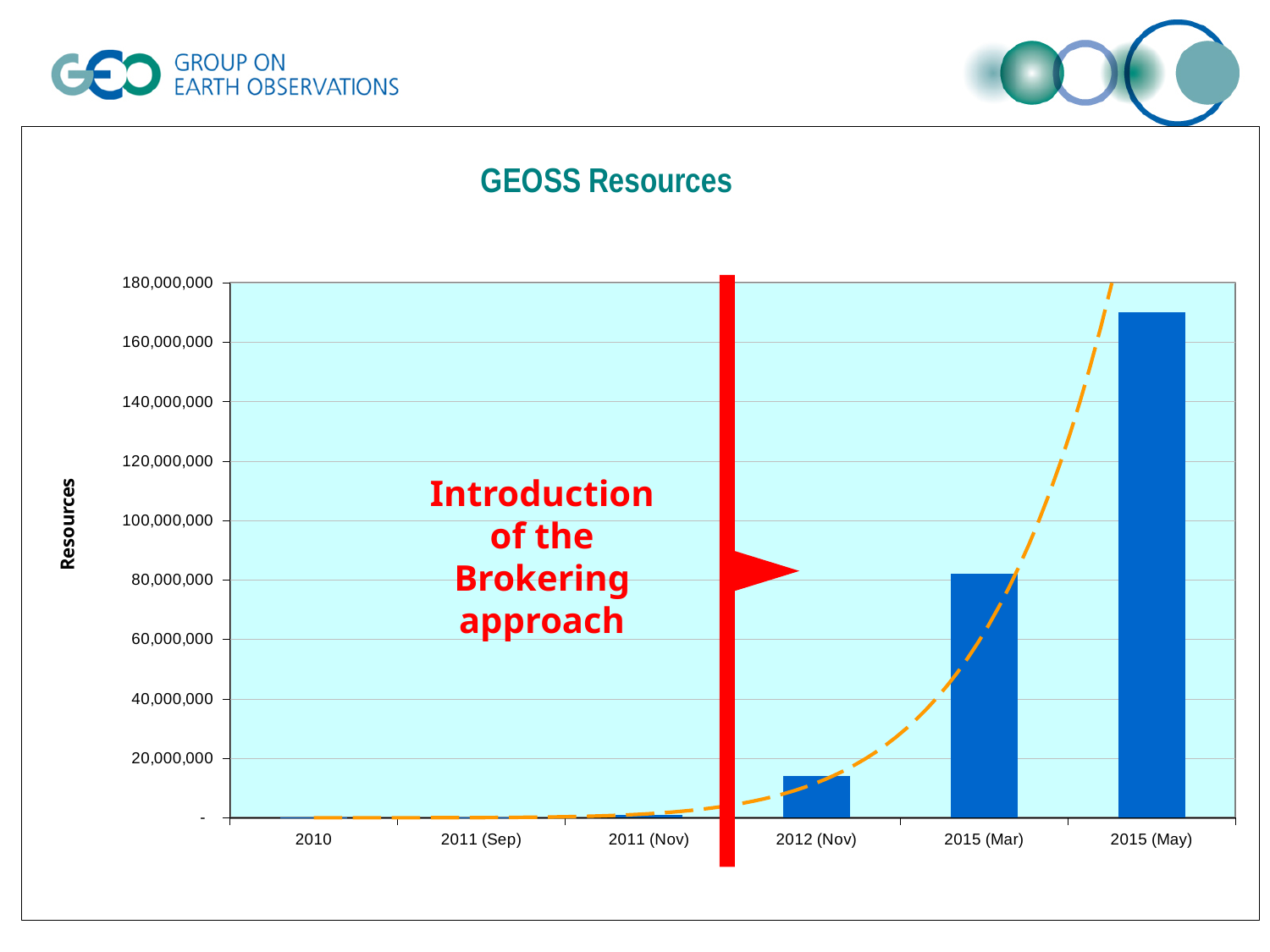
Is the value for 2015 (Mar) greater or less than 100,000,000? less Which is larger, the value for 2015 (Mar) or the value for 2012 (Nov)? 2015 (Mar) Which is larger, the value for 2015 (May) or the value for 2015 (Mar)? 2015 (May) What kind of chart is shown on the slide? bar chart What is the title of the chart? GEOSS Resources Is the value for 2015 (Mar) greater or less than 60,000,000? greater How many categories are shown on the x axis of the chart? 6 Which category has the highest value in the chart? 2015 (May) What is the label of the y axis of the chart? Resources Is the value for 2015 (May) greater or less than 160,000,000? greater Do the values rise or fall along the x axis from 2010 to 2015 (May)? rise